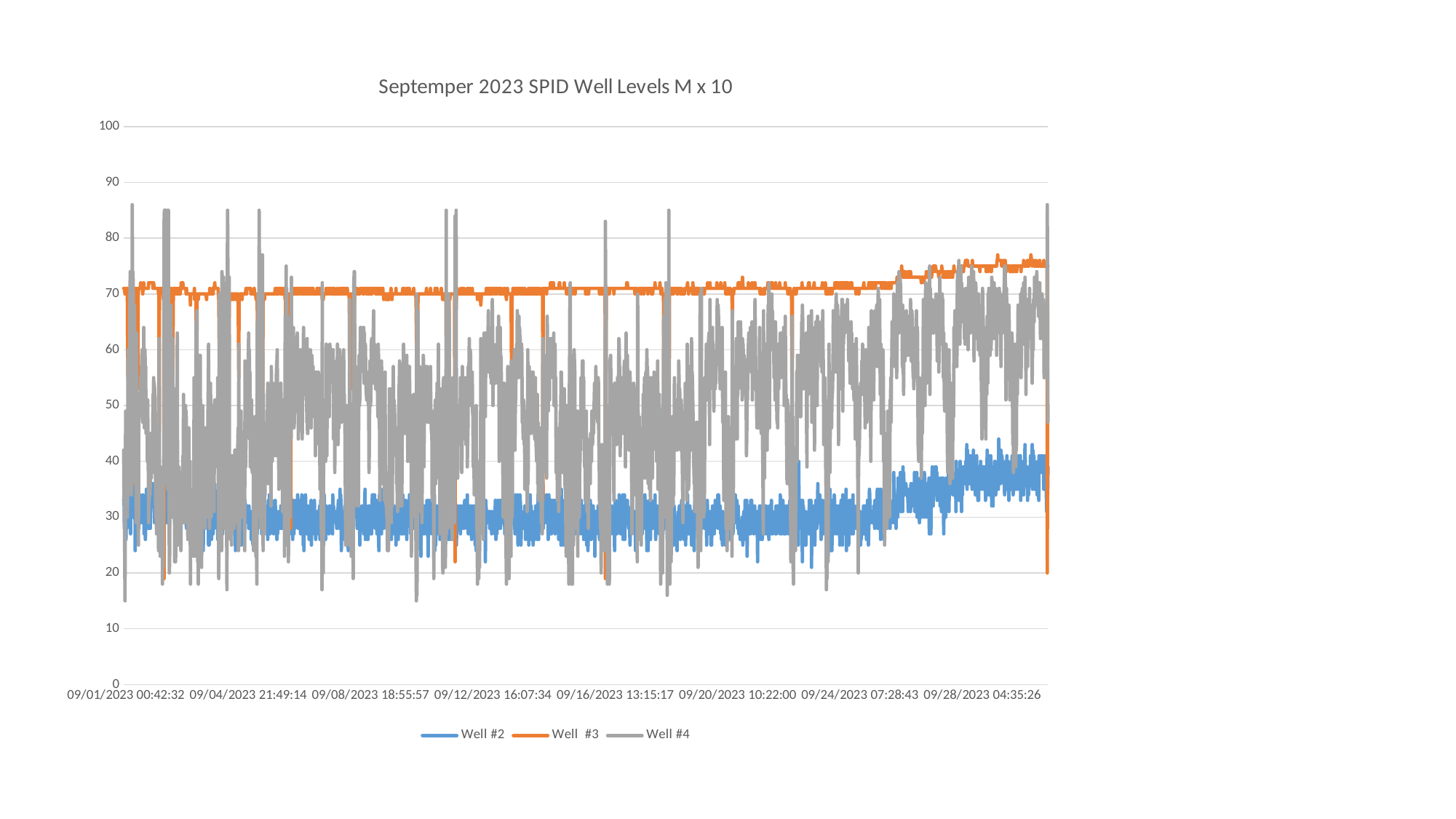
What kind of chart is shown on the slide? Line chart Which series are listed in the legend? Well #2, Well #3, Well #4 Which series generally has the lowest values across the chart? Well #2 What is the highest value shown on the y axis? 100 How many series does the legend list? 3 Which series generally has the highest values across the chart? Well #3 Is the value for Well #2 at the start of the chart greater or less than 50? less What is the title of the chart? Septemper 2023 SPID Well Levels M x 10 Do the values for Well #2 rise or fall from the start to the end of the x axis? Rise Is the value for Well #3 near the end of the chart greater or less than 70? greater Is the value for Well #3 at the start of the chart greater or less than 60? greater